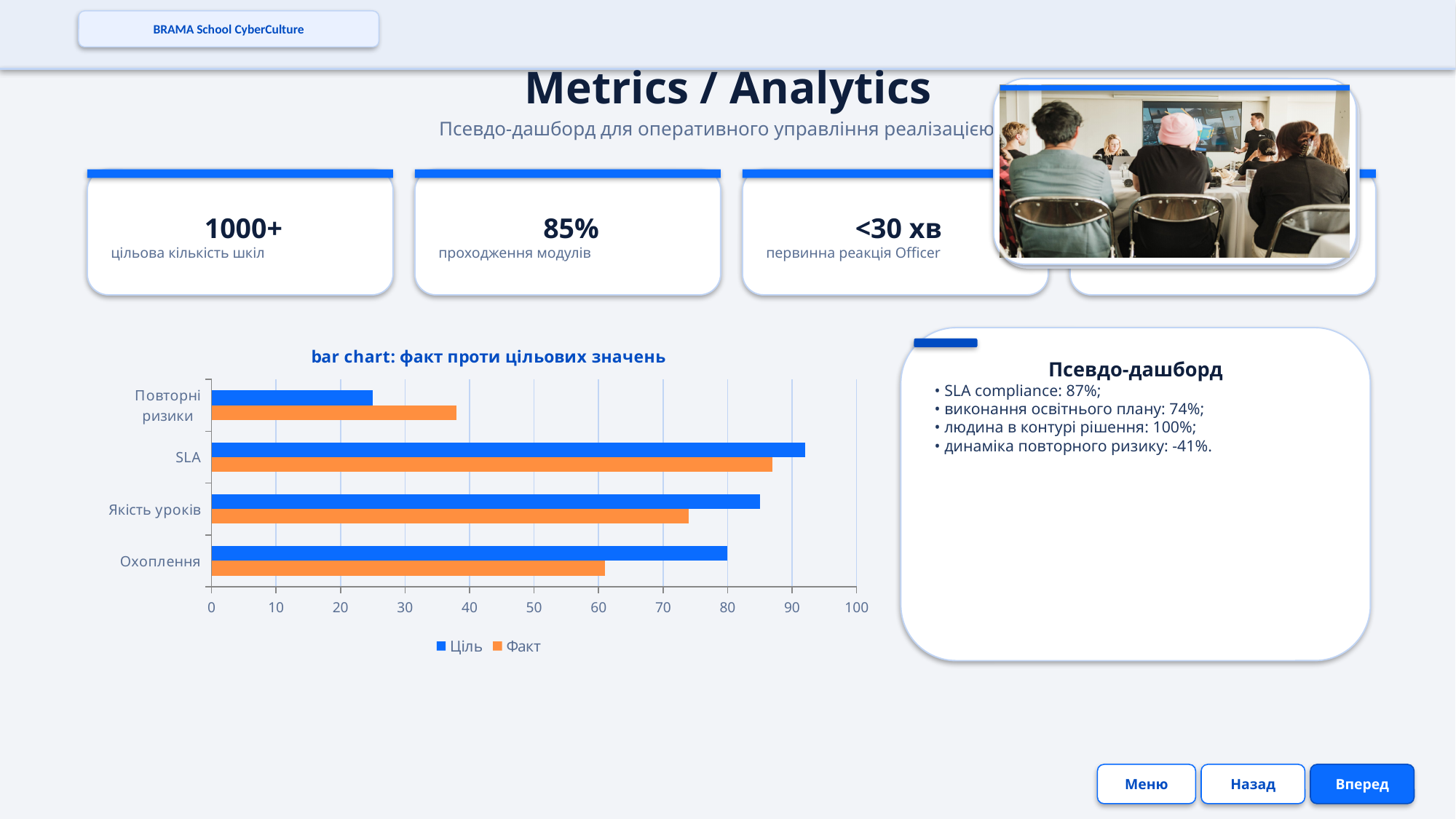
For Охоплення, which is larger: Ціль or Факт? Ціль How many series does the chart legend list? 2 Which category has the lowest Факт value? Повторні ризики Is the Ціль value for SLA greater or less than 80? greater What are the two series names shown in the chart legend? Ціль and Факт What kind of chart is shown on the slide? bar chart How many categories are plotted on the chart? 4 Which category has the highest Ціль value? SLA Which category has the lowest Ціль value? Повторні ризики For Повторні ризики, which is larger: Ціль or Факт? Факт Is the Факт value for Охоплення greater or less than 70? less Which category has the highest Факт value? SLA